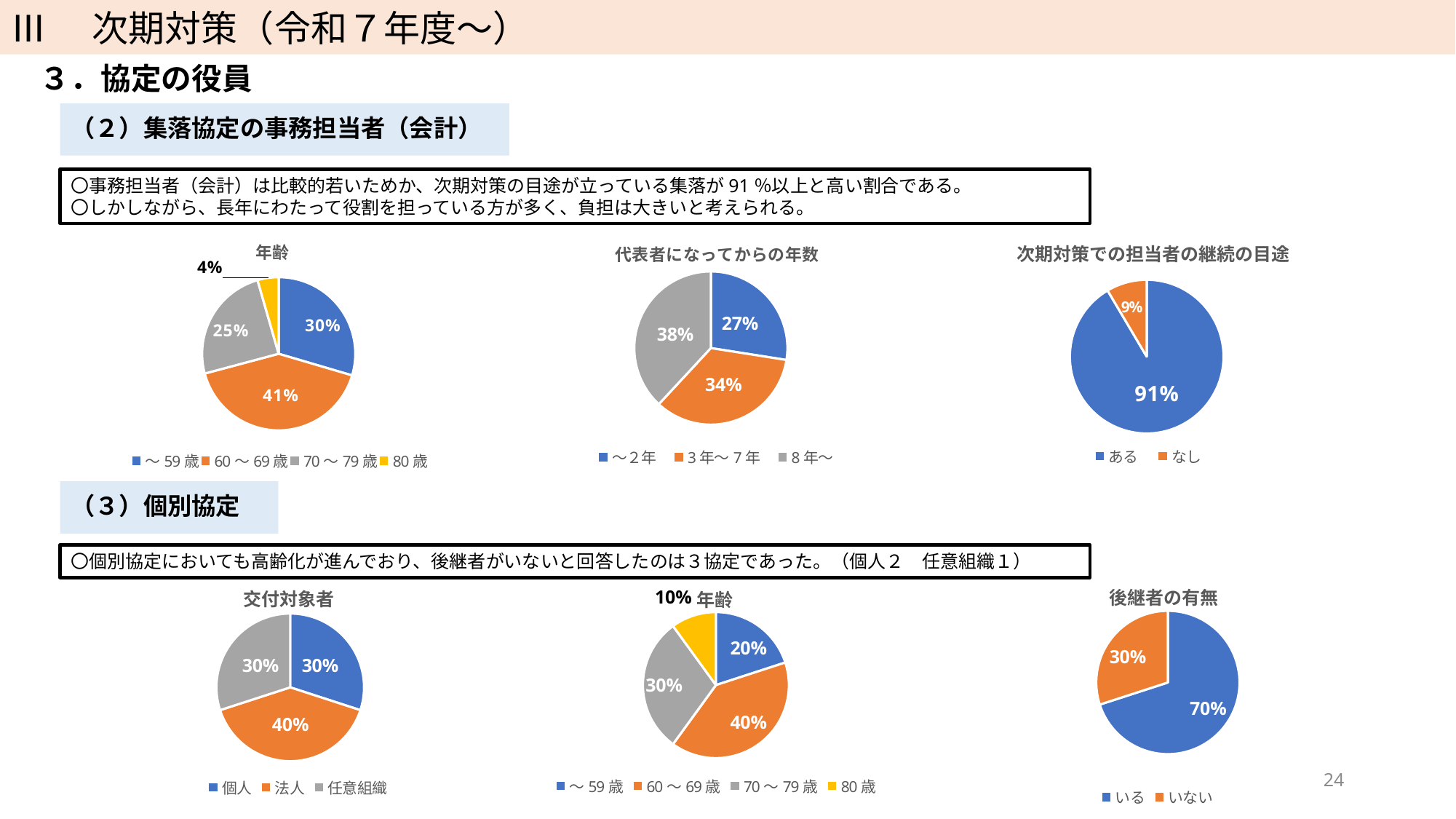
In the '後継者の有無' pie chart, what share is 'いない'? 30% In the '次期対策での担当者の継続の目途' pie chart, what is the difference between 'ある' and 'なし'? 82% In the '代表者になってからの年数' pie chart, what share is '8年～'? 38% What type of chart is used for '後継者の有無'? Pie chart In the '次期対策での担当者の継続の目途' pie chart, what share is 'ある'? 91% In the bottom-row '年齢' pie chart (under (3) 個別協定), what share is '～59歳'? 20% In the top-row '年齢' pie chart (under (2) 集落協定の事務担当者（会計）), what share is '60～69歳'? 41% In the '交付対象者' pie chart, which category has the largest share? 法人 In the bottom-row '年齢' pie chart, which is larger: '70～79歳' or '80歳'? 70～79歳 In the '交付対象者' pie chart, what share is '任意組織'? 30% In the top-row '年齢' pie chart, which category has the smallest share? 80歳 In the '代表者になってからの年数' pie chart, how many categories does the legend list? 3